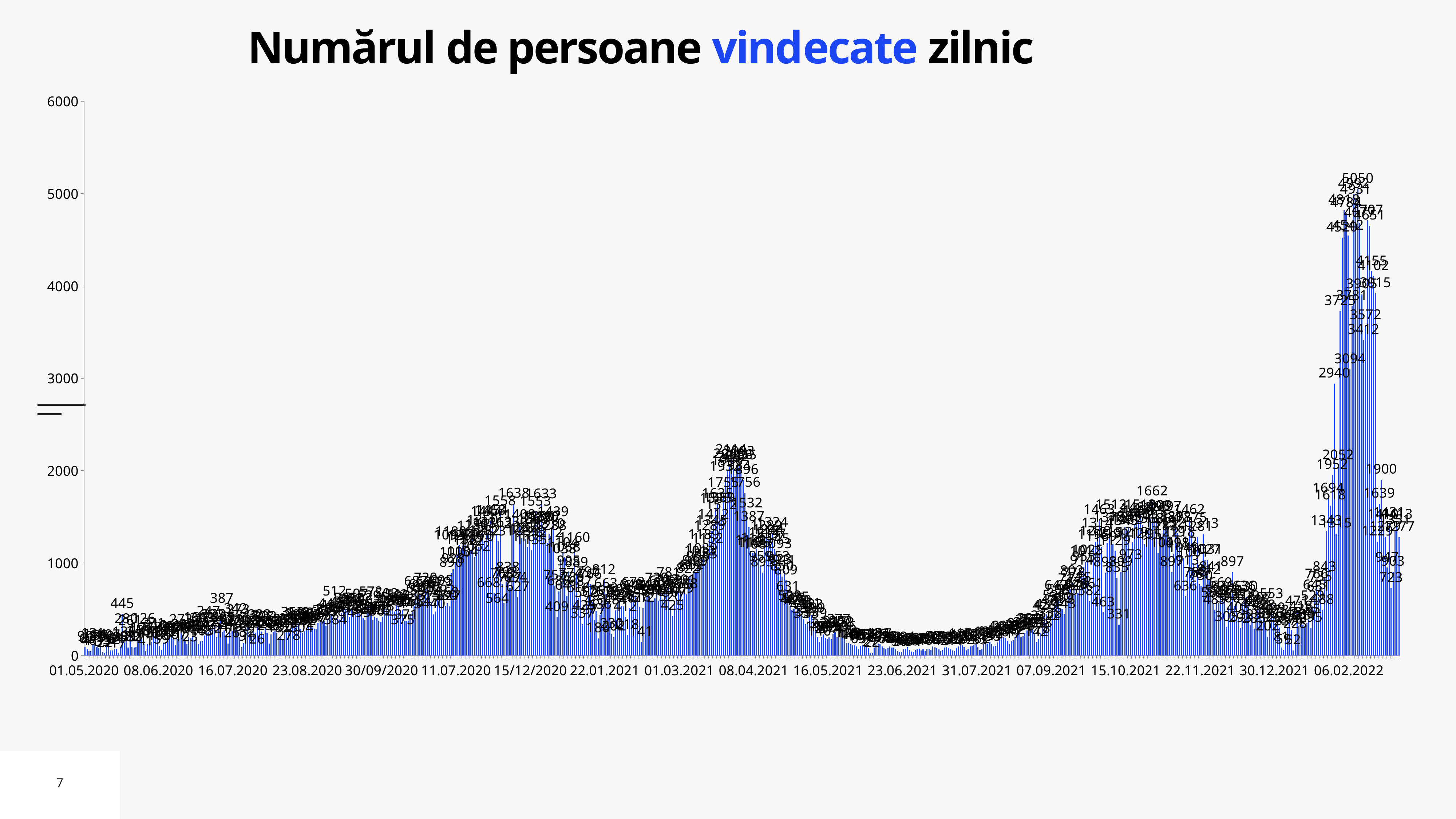
Do the values rise or fall between 08.04.2021 and 23.06.2021? fall What kind of chart is shown on the slide? bar chart What is the title of the chart? Numărul de persoane vindecate zilnic Do the values rise or fall between 23.06.2021 and 15.10.2021? rise Is the highest value in the peak around 06.02.2022 greater or less than 5000? greater What is the maximum value shown on the vertical axis? 6000 Which peak is higher: the one around 08.04.2021 or the one around 06.02.2022? 06.02.2022 Is the highest value in the peak around 08.04.2021 greater or less than 2000? greater Which peak is higher: the one around 15.10.2021 or the one around 08.04.2021? 08.04.2021 What is the highest value labeled on the chart? 5050 Is the value for 01.05.2020 greater or less than 1000? less